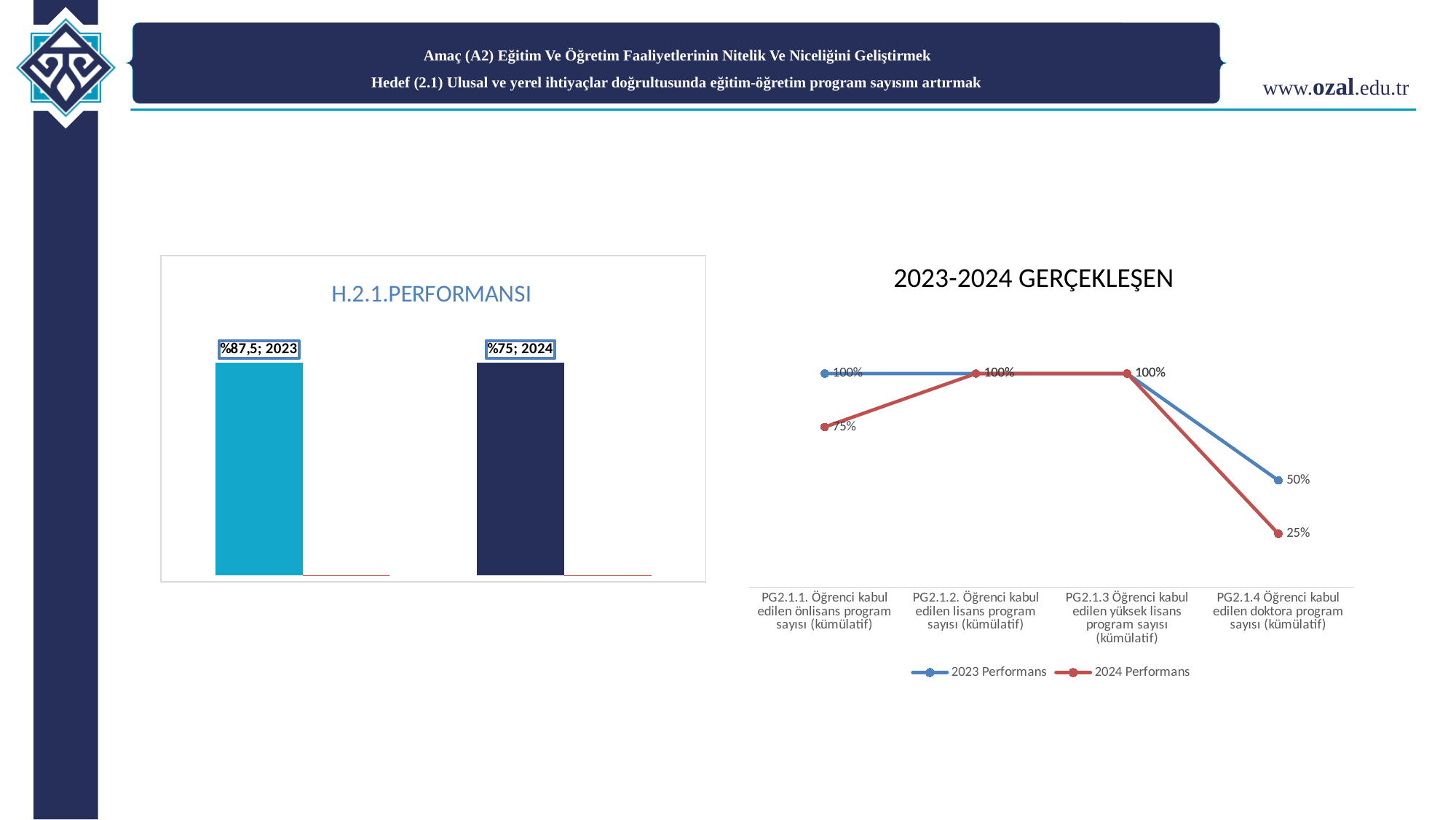
In the H.2.1.PERFORMANSI chart, what is the value for 2024? %75 What kind of chart is the 2023-2024 GERÇEKLEŞEN chart? Line chart In the H.2.1.PERFORMANSI chart, which year has the higher value? 2023 In the 2023-2024 GERÇEKLEŞEN chart, which category has the lowest 2024 Performans value? PG2.1.4 Öğrenci kabul edilen doktora program sayısı (kümülatif) What kind of chart is the H.2.1.PERFORMANSI chart? Bar chart How many series does the legend of the 2023-2024 GERÇEKLEŞEN chart list? 2 In the 2023-2024 GERÇEKLEŞEN chart, what is the difference between the 2023 Performans and 2024 Performans values for PG2.1.4 Öğrenci kabul edilen doktora program sayısı (kümülatif)? 25% How many categories are shown on the x axis of the 2023-2024 GERÇEKLEŞEN chart? 4 In the 2023-2024 GERÇEKLEŞEN chart, what is the 2024 Performans value for PG2.1.4 Öğrenci kabul edilen doktora program sayısı (kümülatif)? 25% In the 2023-2024 GERÇEKLEŞEN chart, what is the 2023 Performans value for PG2.1.4 Öğrenci kabul edilen doktora program sayısı (kümülatif)? 50% In the 2023-2024 GERÇEKLEŞEN chart, what is the 2024 Performans value for PG2.1.1. Öğrenci kabul edilen önlisans program sayısı (kümülatif)? 75% In the H.2.1.PERFORMANSI chart, what is the value for 2023? %87,5